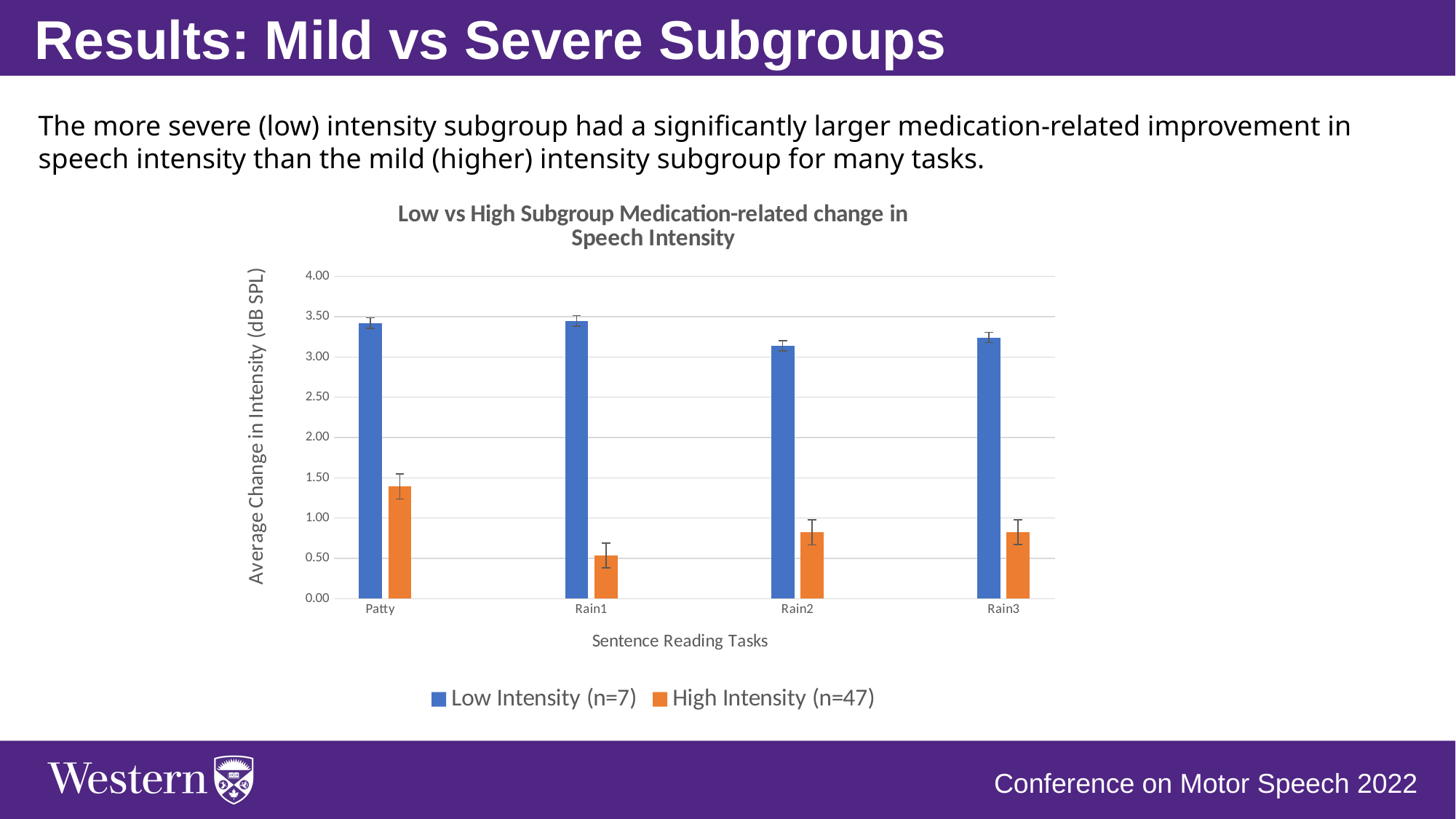
Is the High Intensity (n=47) value for Patty greater or less than 1.00? greater How many series does the legend list? 2 For the High Intensity (n=47) series, which is larger, Rain1 or Rain2? Rain2 Is the Low Intensity (n=7) value for Rain2 greater or less than 3.00? greater For Patty, which series has the larger value, Low Intensity (n=7) or High Intensity (n=47)? Low Intensity (n=7) Is the Low Intensity (n=7) value for Patty greater or less than 3.00? greater What is the label of the y axis? Average Change in Intensity (dB SPL) Which task has the highest value for the High Intensity (n=47) series? Patty Which task has the lowest value for the High Intensity (n=47) series? Rain1 How many sentence reading tasks are shown on the x axis? 4 What kind of chart is shown on the slide? bar chart